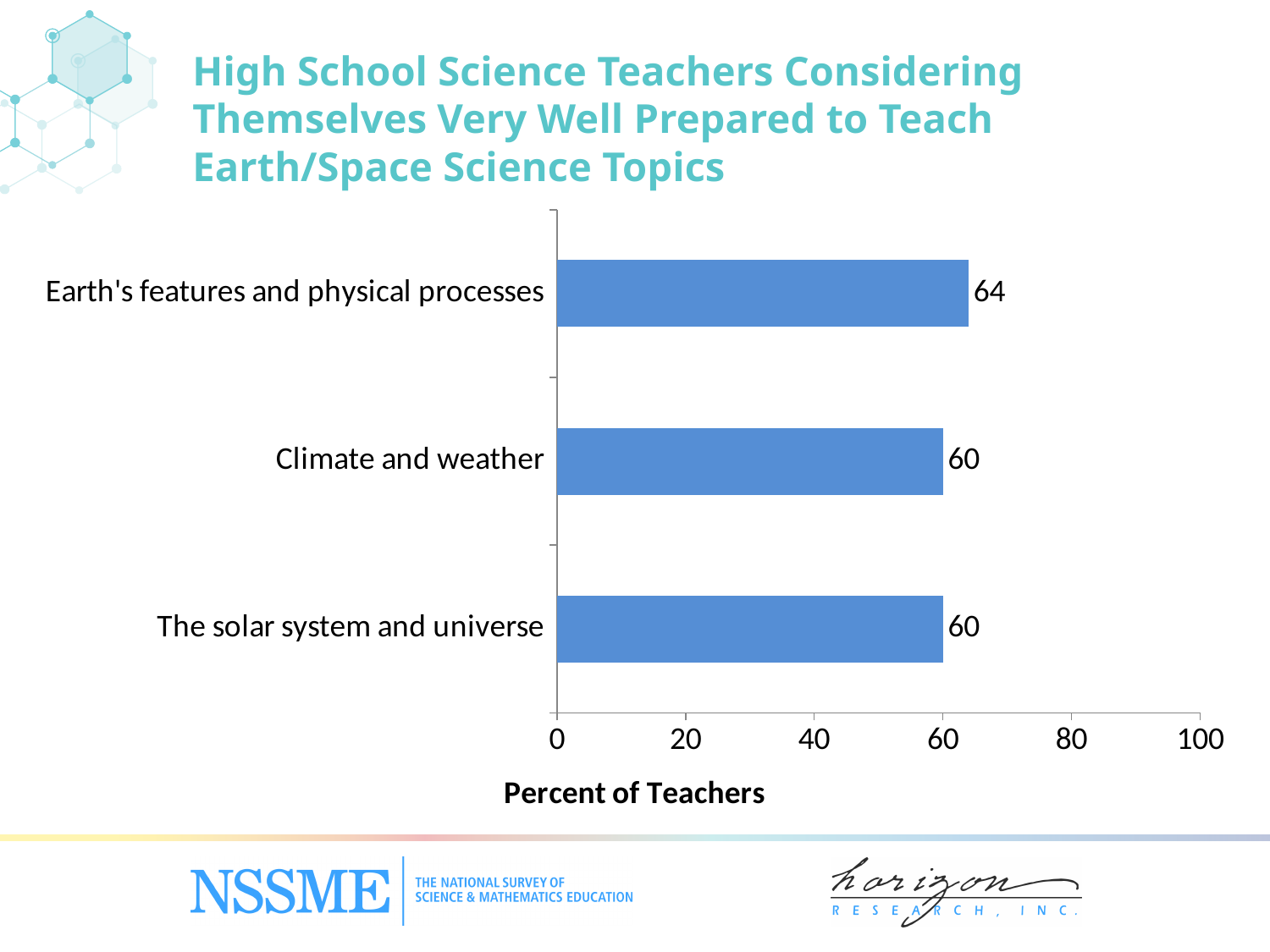
Is the value for Earth's features and physical processes greater or less than 40? greater What is the maximum value shown on the horizontal axis? 100 What kind of chart is shown on the slide? bar chart What is the difference between the values for Earth's features and physical processes and Climate and weather? 4 What percent of teachers consider themselves very well prepared to teach Earth's features and physical processes? 64 What is the value for Climate and weather? 60 Is the value for Climate and weather greater or less than 80? less Which topic has the highest percent of teachers? Earth's features and physical processes How many topics are shown in the chart? 3 What is the label of the horizontal axis? Percent of Teachers What is the value for The solar system and universe? 60 Which is larger, the value for Earth's features and physical processes or the value for The solar system and universe? Earth's features and physical processes